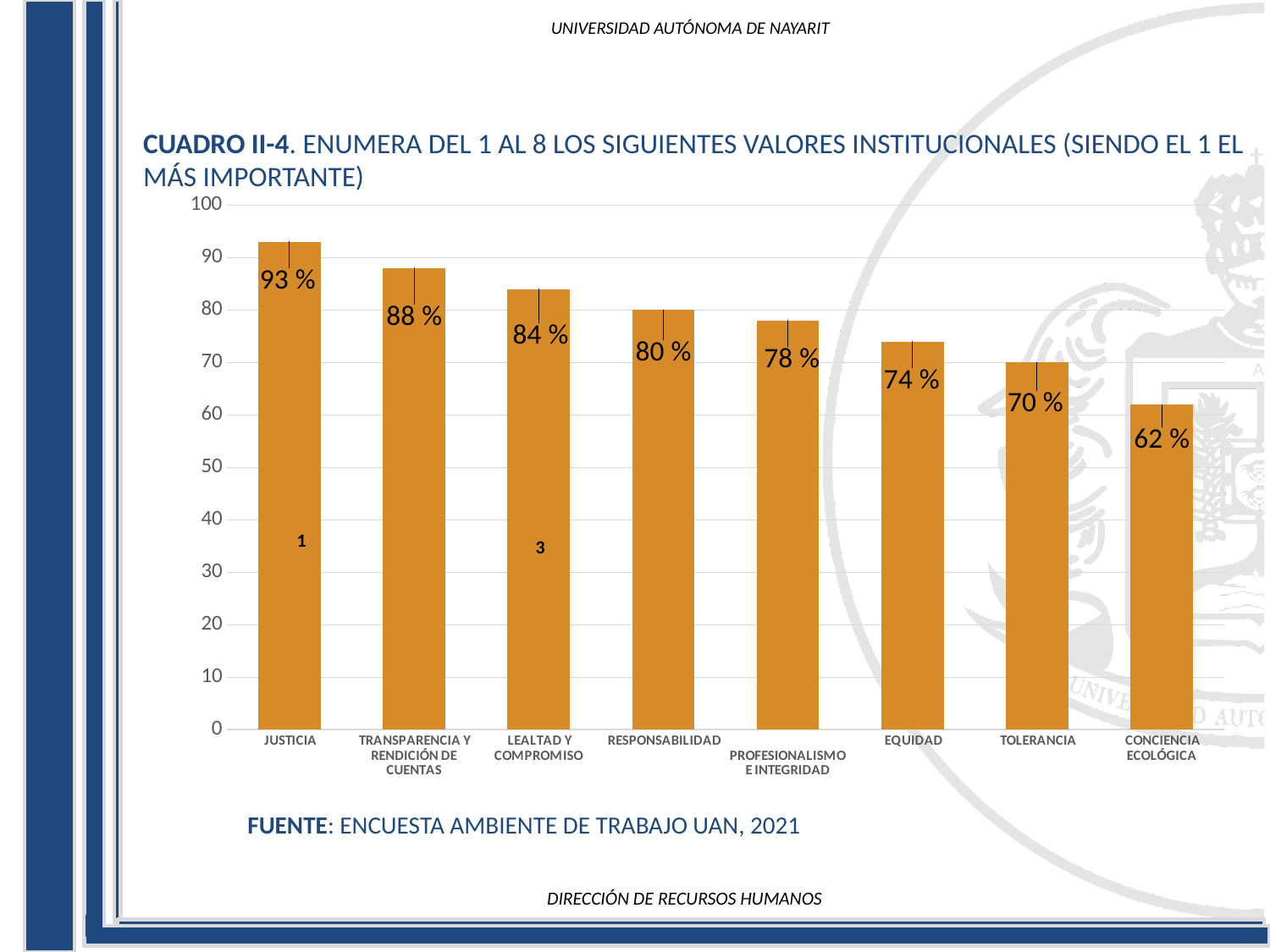
What is the value for TOLERANCIA? 70 % Which is larger, the value for LEALTAD Y COMPROMISO or the value for RESPONSABILIDAD? LEALTAD Y COMPROMISO How many categories are shown on the chart? 8 Is the value for EQUIDAD greater or less than 70? greater Do the values rise or fall from left to right along the x axis? fall What kind of chart is shown on the slide? bar chart What is the difference between the values for JUSTICIA and CONCIENCIA ECOLÓGICA? 31 % What is the value for PROFESIONALISMO E INTEGRIDAD? 78 % What is the value for JUSTICIA? 93 % Which category has the highest value? JUSTICIA What is the difference between the values for TRANSPARENCIA Y RENDICIÓN DE CUENTAS and EQUIDAD? 14 % Which category has the lowest value? CONCIENCIA ECOLÓGICA